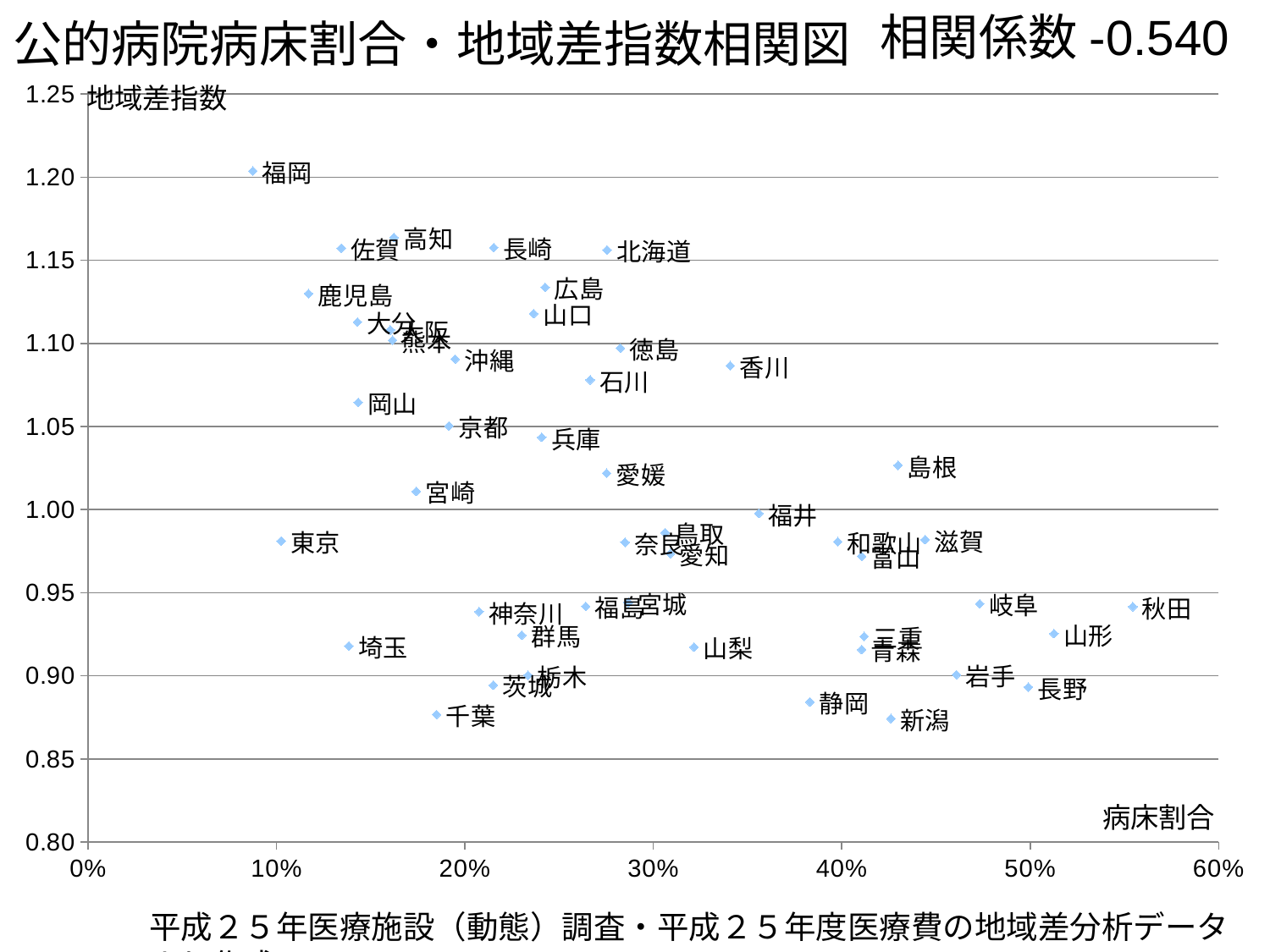
Is the 地域差指数 value for 福岡 greater or less than 1.15? greater Which prefecture has the highest 地域差指数 value on the chart? 福岡 Which prefecture has the lowest 病床割合 (x-axis) value on the chart? 福岡 Is the 病床割合 value for 秋田 greater or less than 50%? greater Is the 地域差指数 value for 東京 greater or less than 1.00? less Which prefecture has the highest 病床割合 (x-axis) value on the chart? 秋田 What kind of chart is shown on the slide? scatter plot As 病床割合 increases along the x axis, does 地域差指数 generally rise or fall? fall Which has the larger 地域差指数 value, 福岡 or 東京? 福岡 Which has the larger 地域差指数 value, 島根 or 新潟? 島根 What correlation coefficient is stated in the chart title? -0.540